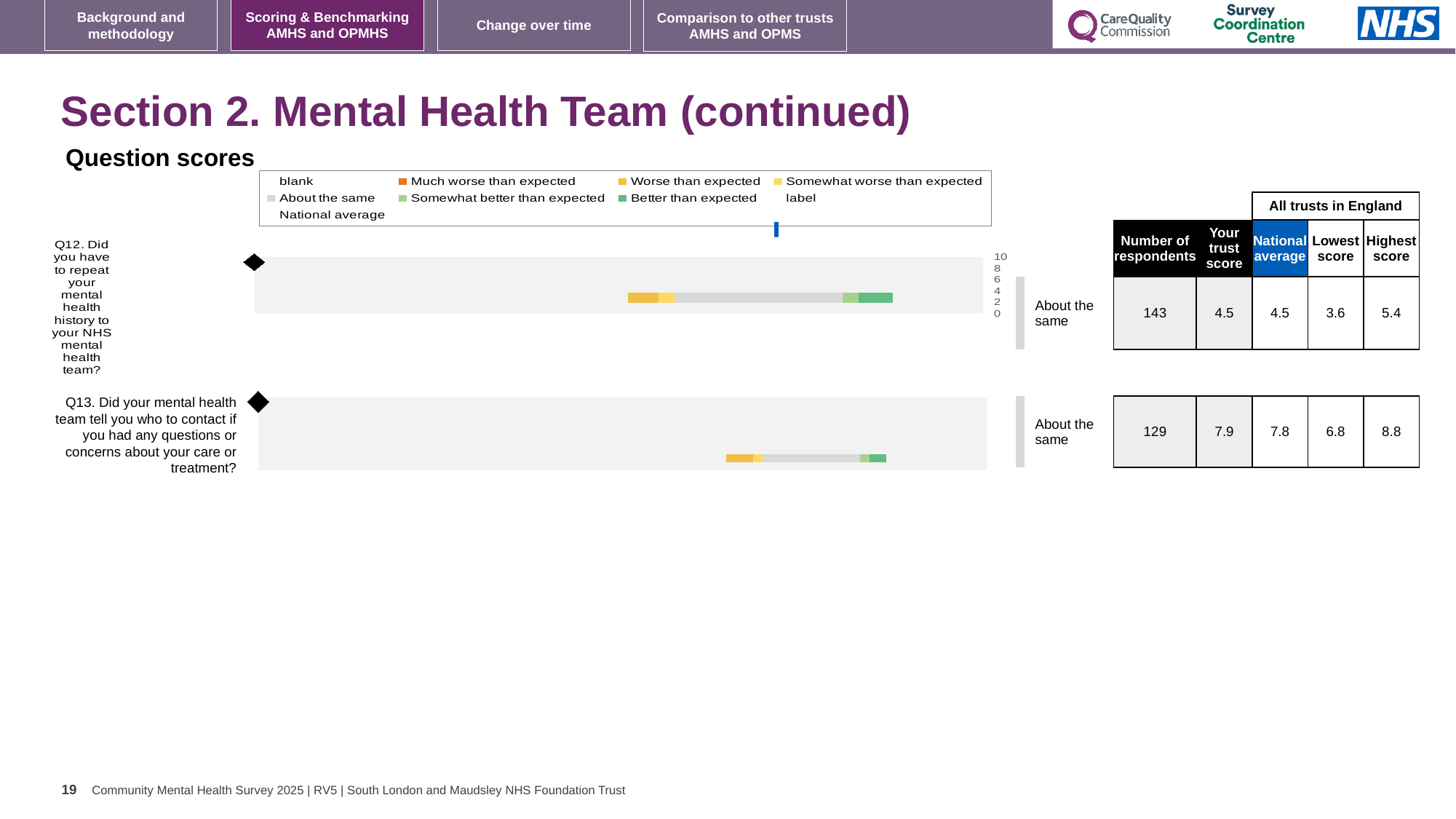
How many questions (bars) are shown in the question scores chart? 2 What is the benchmark category shown next to the bar for Q13? About the same What kind of chart is used to show the question scores for Q12 and Q13? bar chart What is the benchmark category shown next to the bar for Q12? About the same What is the trust score for Q13 (told who to contact with questions or concerns)? 7.9 What is the difference between the trust score and the national average for Q13? 0.1 How many respondents answered Q12? 143 Which question has the higher trust score, Q12 or Q13? Q13 What is the national average for Q13? 7.8 What is the trust score for Q12 (repeating mental health history)? 4.5 What is the difference between the highest score and the lowest score for Q12 across all trusts in England? 1.8 What colour does the legend use for 'Better than expected'? green